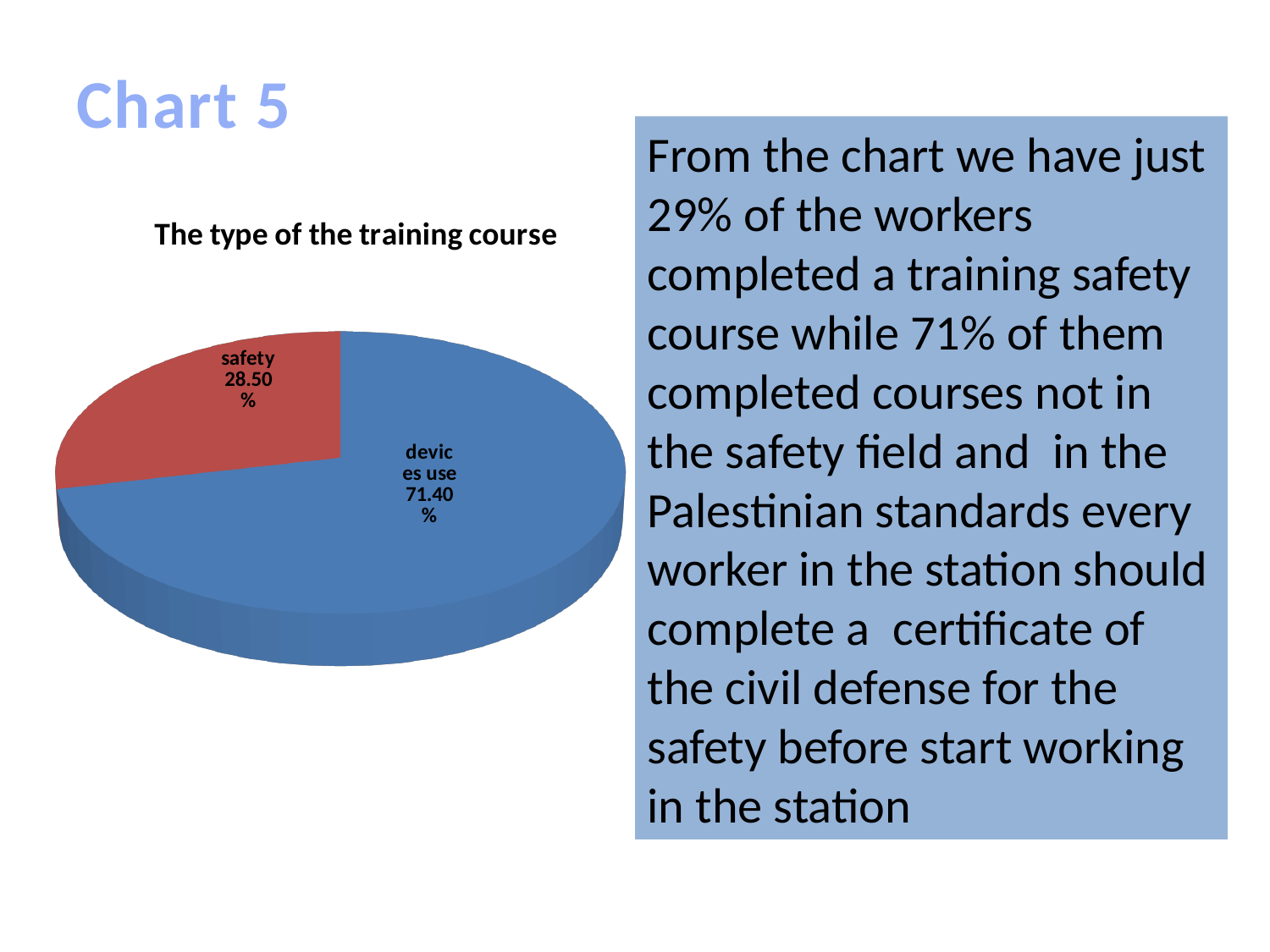
Which slice of the pie is the largest? devices use Which slice of the pie is the smallest? safety What colour is the "safety" slice? red How many slices does the pie chart have? 2 What is the difference in percentage points between the "devices use" slice and the "safety" slice? 42.90 Which is larger, the "safety" slice or the "devices use" slice? devices use What share of the pie is labelled "safety"? 28.50% What share of the pie is labelled "devices use"? 71.40% What kind of chart is shown on the slide? pie chart What is the title of the chart? The type of the training course